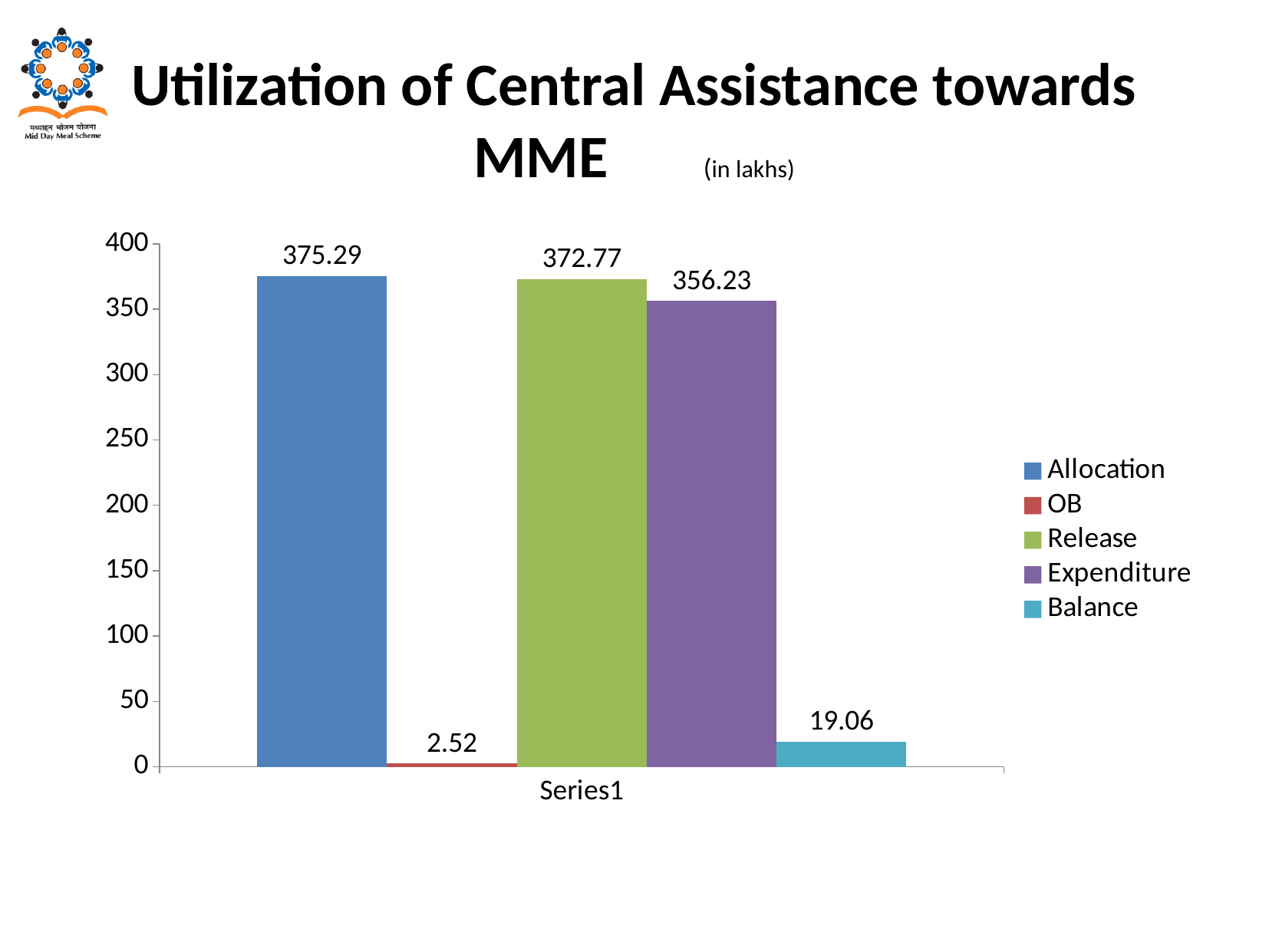
What is the value for Release? 372.77 What is the value for Allocation? 375.29 What is the value for OB? 2.52 What is the value for Expenditure? 356.23 What is the difference between Release and Expenditure? 16.54 Which series has the highest value? Allocation Which is larger, Expenditure or Balance? Expenditure How many series does the legend list? 5 What kind of chart is shown on the slide? bar chart What is the value for Balance? 19.06 Is the value for Expenditure greater or less than 350? greater Which series has the lowest value? OB